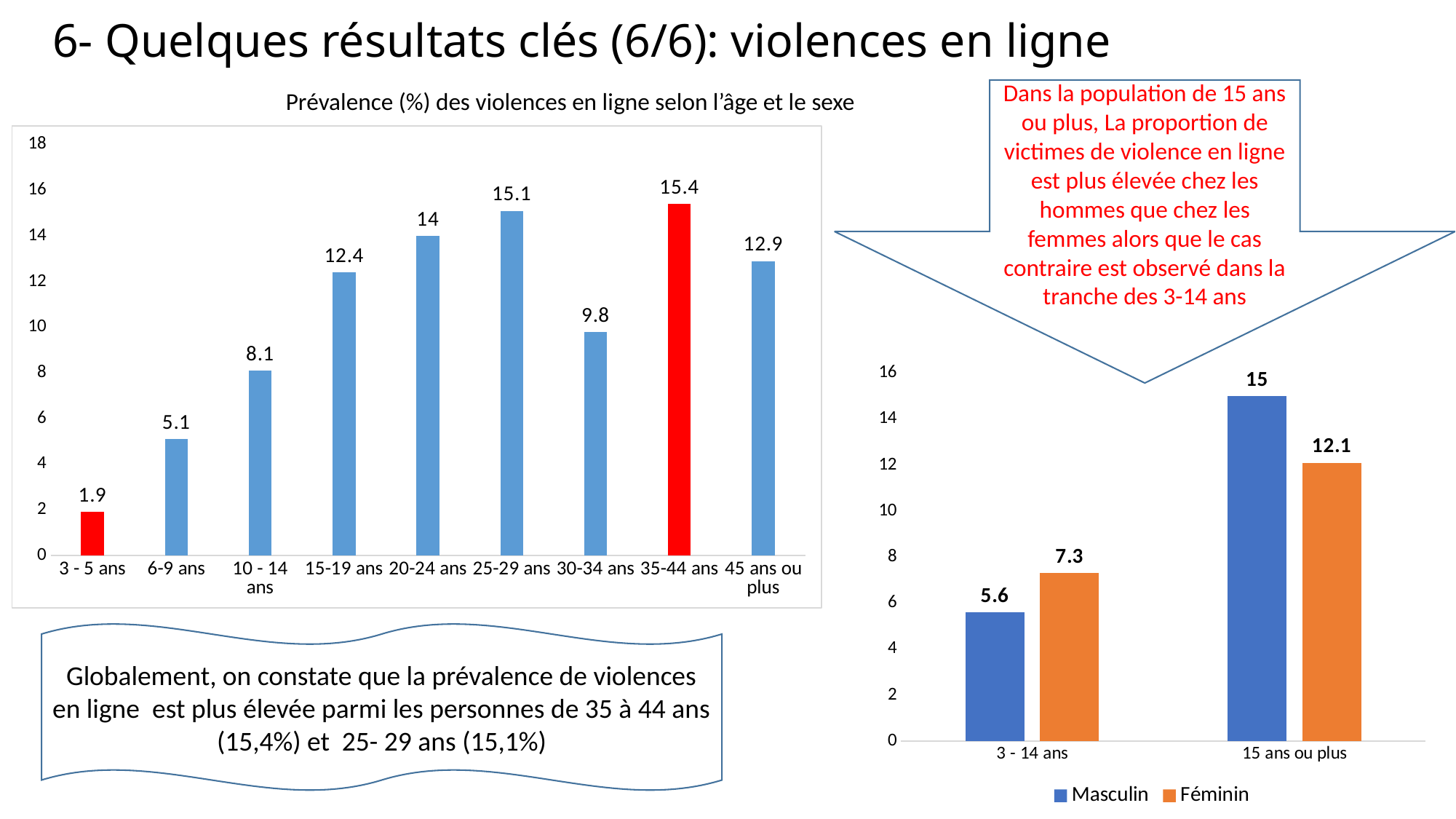
In the left chart (prevalence by age), which age group has the lowest value? 3 - 5 ans In the left chart (prevalence by age), which is larger, the value for 20-24 ans or 45 ans ou plus? 20-24 ans In the left chart (prevalence by age), what is the difference between the values for 25-29 ans and 30-34 ans? 5.3 In the right chart (by sex), what is the difference between Masculin and Féminin in the 3 - 14 ans group? 1.7 In the left chart (prevalence by age), which age group has the highest value? 35-44 ans In the right chart (by sex), what is the value for Féminin in the 15 ans ou plus group? 12.1 In the left chart (prevalence by age), how many age groups are shown? 9 In the right chart (by sex), how many series does the legend list? 2 In the left chart (prevalence by age), what is the value for 35-44 ans? 15.4 In the left chart (prevalence by age), which bars are coloured red? 3 - 5 ans and 35-44 ans In the left chart (prevalence by age), what is the value for 10 - 14 ans? 8.1 What type of chart is the right chart (by sex)? Bar chart